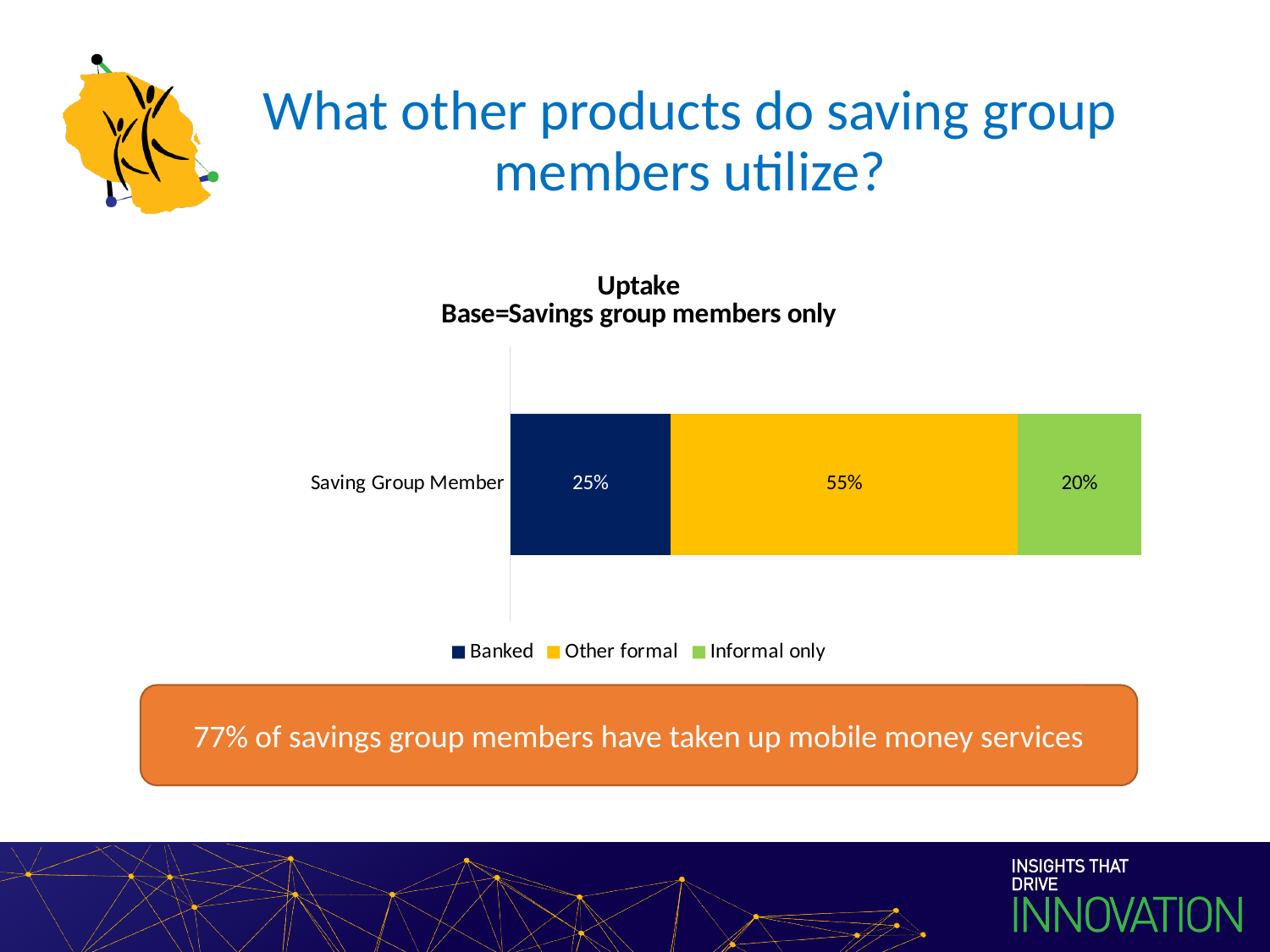
Which series has the largest share of the Saving Group Member bar? Other formal How many categories are plotted on the chart? 1 What percentage of saving group members use Other formal products? 55% What is the difference between the Other formal and Banked percentages? 30% What is the total of the three segments in the Saving Group Member bar? 100% What percentage of saving group members are Informal only? 20% Which series has the smallest share of the Saving Group Member bar? Informal only Which is larger, the Banked share or the Informal only share? Banked How many series does the legend list? 3 What colour represents the Banked series in the chart? Dark blue What percentage of saving group members are Banked? 25% What kind of chart is shown on the slide? Stacked bar chart